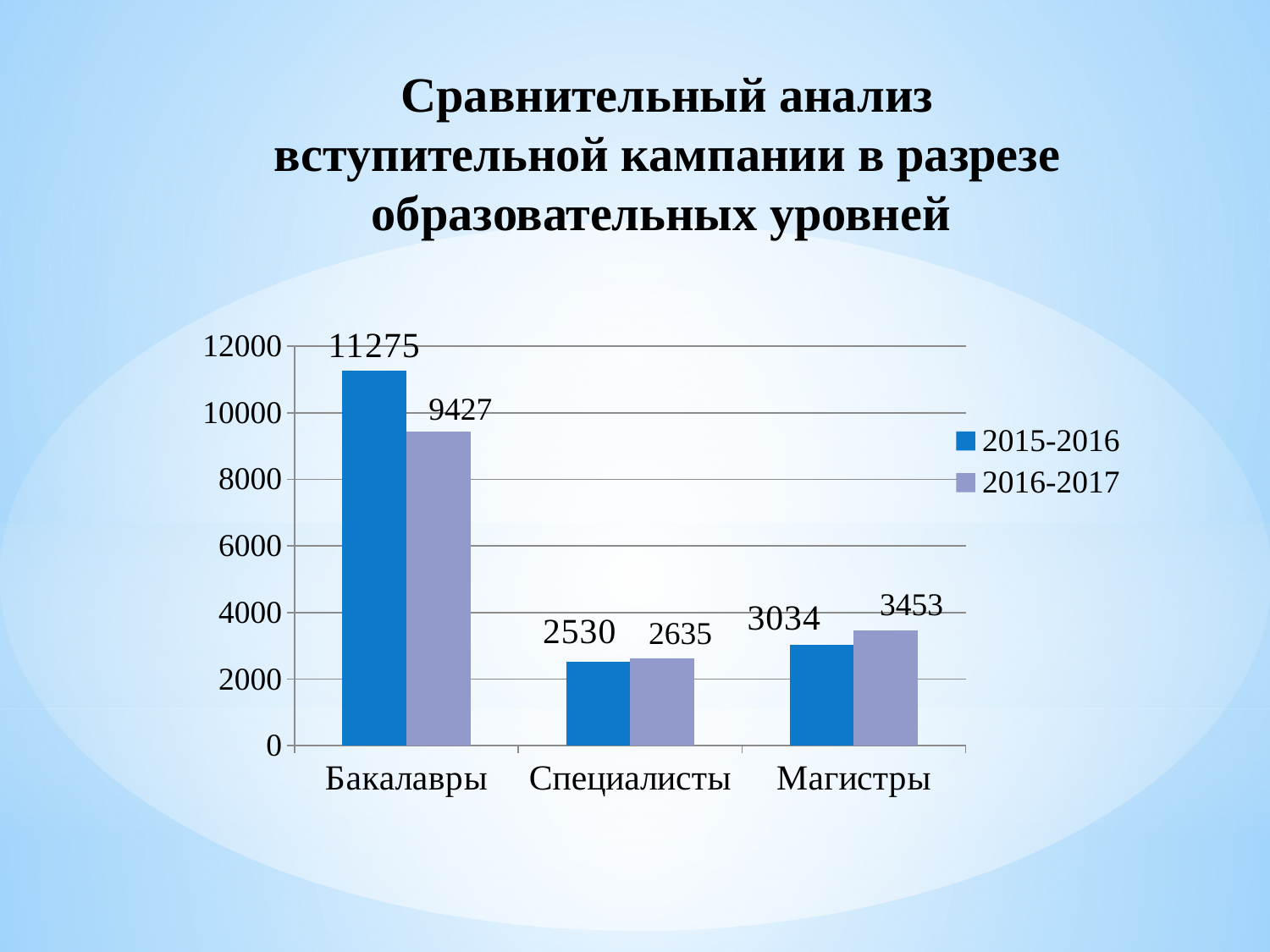
Which category has the lowest value in the 2015-2016 series? Специалисты What is the difference between the 2015-2016 and 2016-2017 values for Бакалавры? 1848 What is the value for Бакалавры in the 2015-2016 series? 11275 What is the value for Специалисты in the 2015-2016 series? 2530 Which category has the highest value in the 2016-2017 series? Бакалавры Which is larger for Магистры: the 2015-2016 value or the 2016-2017 value? 2016-2017 How many series does the legend list? 2 What is the value for Магистры in the 2016-2017 series? 3453 How many categories are shown on the x axis? 3 What kind of chart is shown on the slide? bar chart What are the two series named in the legend? 2015-2016 and 2016-2017 Is the 2016-2017 value for Бакалавры greater or less than 10000? less